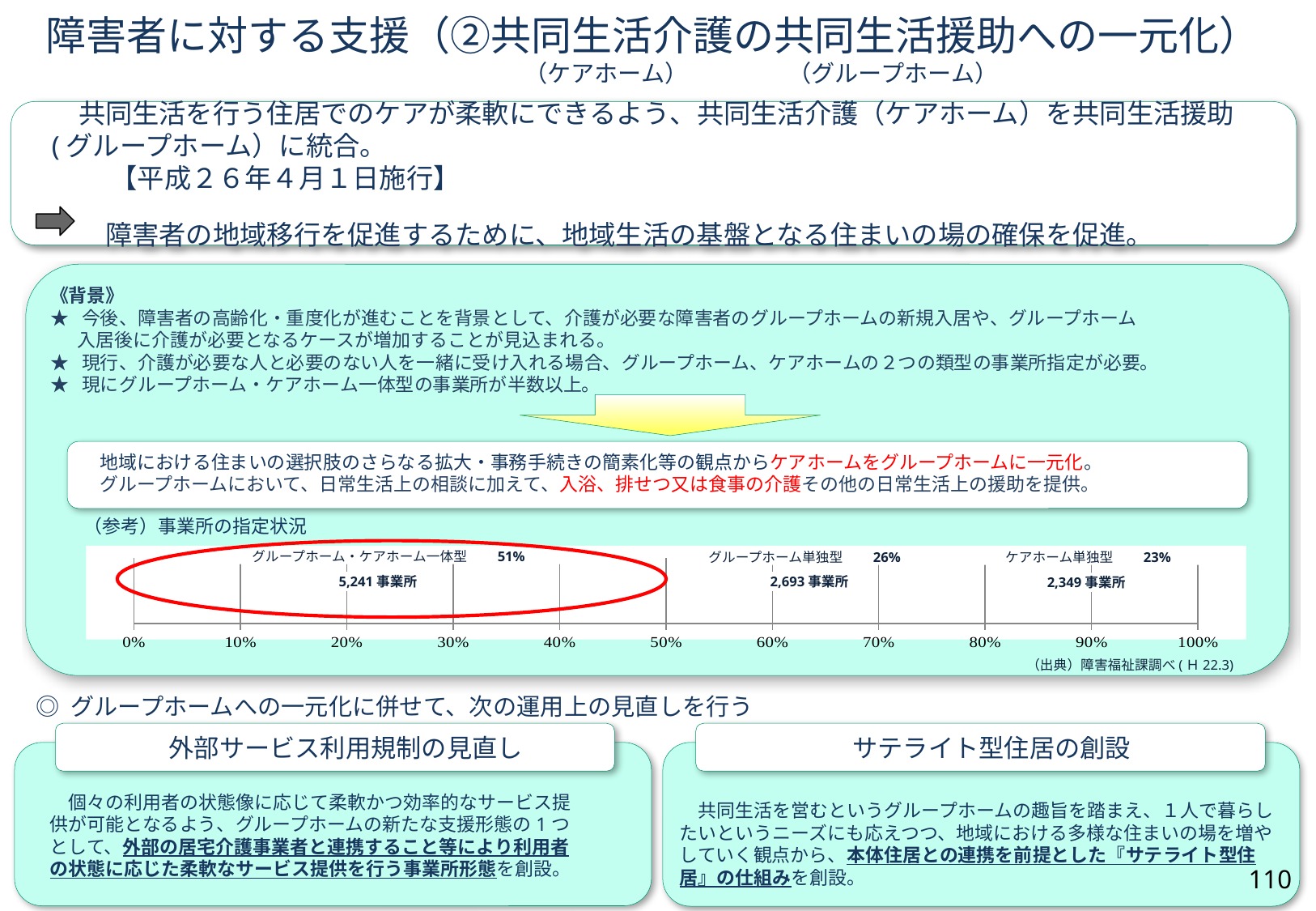
What kind of chart is the one titled （参考）事業所の指定状況? Stacked horizontal bar chart In the chart titled （参考）事業所の指定状況, what percentage is shown for ケアホーム単独型? 23% In the chart titled （参考）事業所の指定状況, how many 事業所 are shown for グループホーム単独型? 2,693 事業所 In the chart titled （参考）事業所の指定状況, how many percentage points larger is the share of グループホーム・ケアホーム一体型 than that of グループホーム単独型? 25 In the chart titled （参考）事業所の指定状況, how many 事業所 are shown for ケアホーム単独型? 2,349 事業所 In the chart titled （参考）事業所の指定状況, which has more 事業所: グループホーム単独型 or ケアホーム単独型? グループホーム単独型 In the chart titled （参考）事業所の指定状況, what percentage is shown for グループホーム・ケアホーム一体型? 51% What is the total number of 事業所 across all three categories in the chart titled （参考）事業所の指定状況? 10,283 In the chart titled （参考）事業所の指定状況, which category has the smallest share? ケアホーム単独型 In the chart titled （参考）事業所の指定状況, what is the difference in the number of 事業所 between グループホーム・ケアホーム一体型 and ケアホーム単独型? 2,892 In the chart titled （参考）事業所の指定状況, which category has the largest share? グループホーム・ケアホーム一体型 How many categories are shown in the chart titled （参考）事業所の指定状況? 3